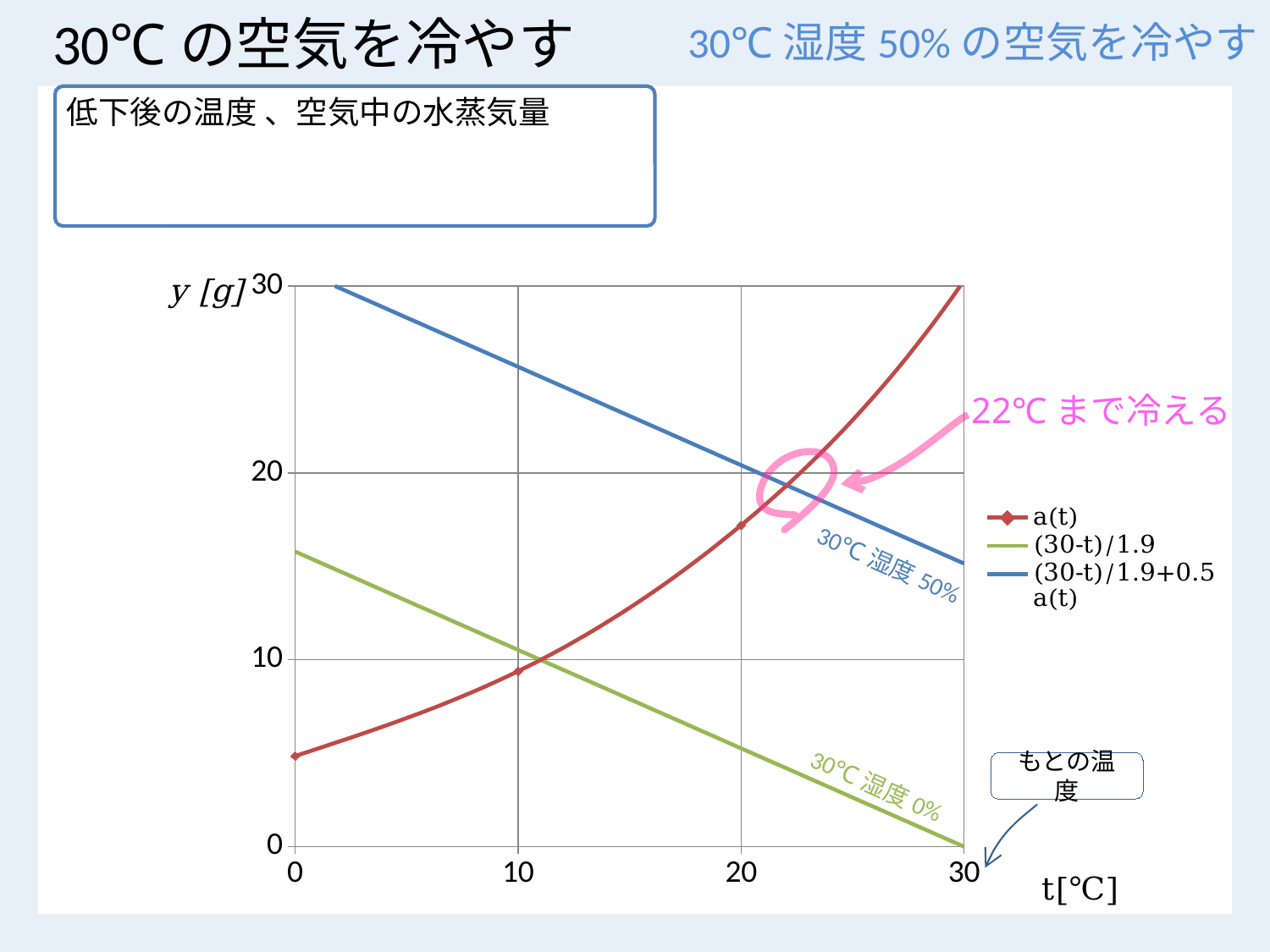
What is the value of the series (30-t)/1.9 at t = 30? 0 Does the series (30-t)/1.9 rise or fall as t increases? fall What is the label of the x axis of the chart? t[℃] Is the value of a(t) at t = 20 greater or less than 20? less What is the label of the y axis of the chart? y [g] Is the value of (30-t)/1.9+0.5 a(t) at t = 10 greater or less than 20? greater At t = 0, which series has the larger value, a(t) or (30-t)/1.9? (30-t)/1.9 Is the value of (30-t)/1.9 at t = 20 greater or less than 10? less What kind of chart is shown on the slide? line chart Which series has the highest value at t = 30? a(t) Does the series a(t) rise or fall as t increases? rise How many series does the chart legend list? 3